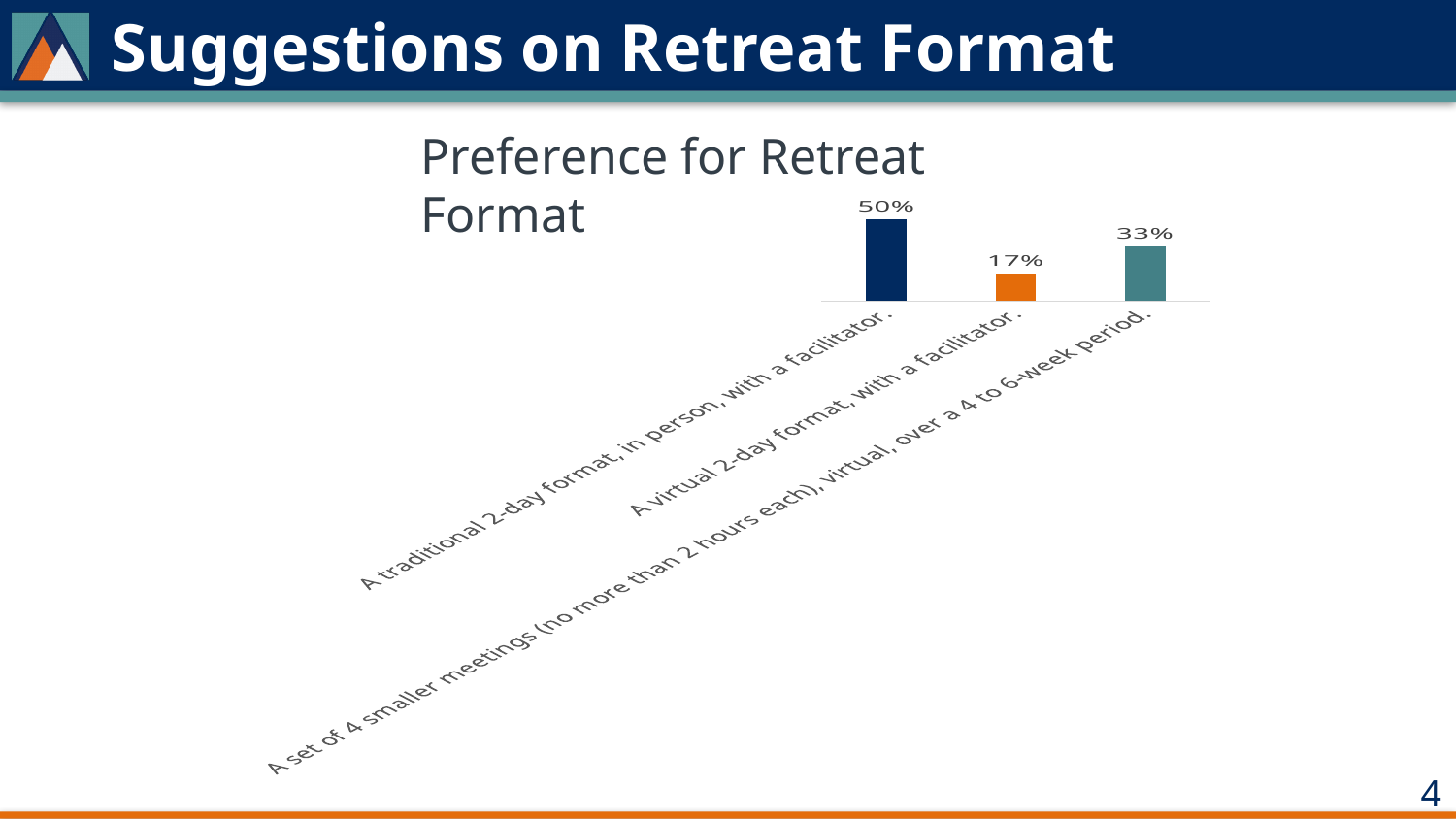
What is the title of the chart? Preference for Retreat Format What is the value for 'A virtual 2-day format, with a facilitator.'? 17% Which has a larger preference: the virtual 2-day format or the set of 4 smaller meetings? A set of 4 smaller meetings (no more than 2 hours each), virtual, over a 4 to 6-week period. Which retreat format has the lowest preference? A virtual 2-day format, with a facilitator. What is the difference between the preference for the set of 4 smaller virtual meetings and the virtual 2-day format? 16% What kind of chart is shown on the slide? Bar chart How many retreat format categories are shown in the chart? 3 What colour is the bar for 'A virtual 2-day format, with a facilitator.'? Orange What is the difference between the preference for the traditional 2-day in-person format and the virtual 2-day format? 33% Which retreat format has the highest preference? A traditional 2-day format, in person, with a facilitator. What is the value for 'A traditional 2-day format, in person, with a facilitator.'? 50% What is the value for 'A set of 4 smaller meetings (no more than 2 hours each), virtual, over a 4 to 6-week period.'? 33%